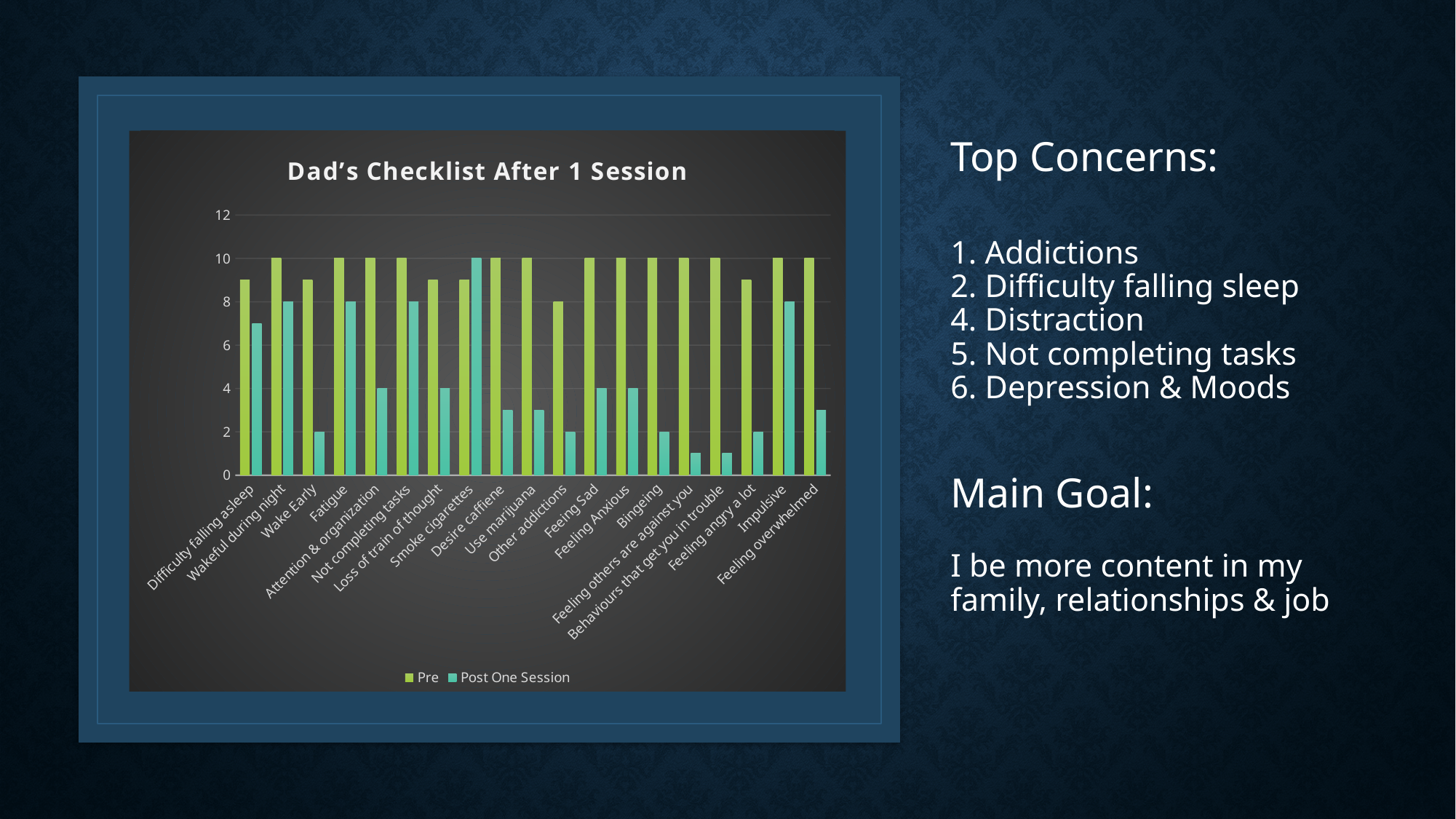
What is the Post One Session value for Impulsive? 8 How many series does the legend of the chart list? 2 Is the Post One Session value for Difficulty falling asleep greater or less than 6? greater What is the title of the chart? Dad's Checklist After 1 Session Which category has the highest Post One Session value? Smoke cigarettes How many categories are plotted along the x axis of the chart? 19 What is the difference between the Pre and Post One Session values for Fatigue? 2 What is the difference between the Pre and Post One Session values for Attention & organization? 6 What is the Pre value for Other addictions? 8 Which has the larger Post One Session value: Smoke cigarettes or Bingeing? Smoke cigarettes What kind of chart is shown on the slide? bar chart What is the Post One Session value for Wake Early? 2